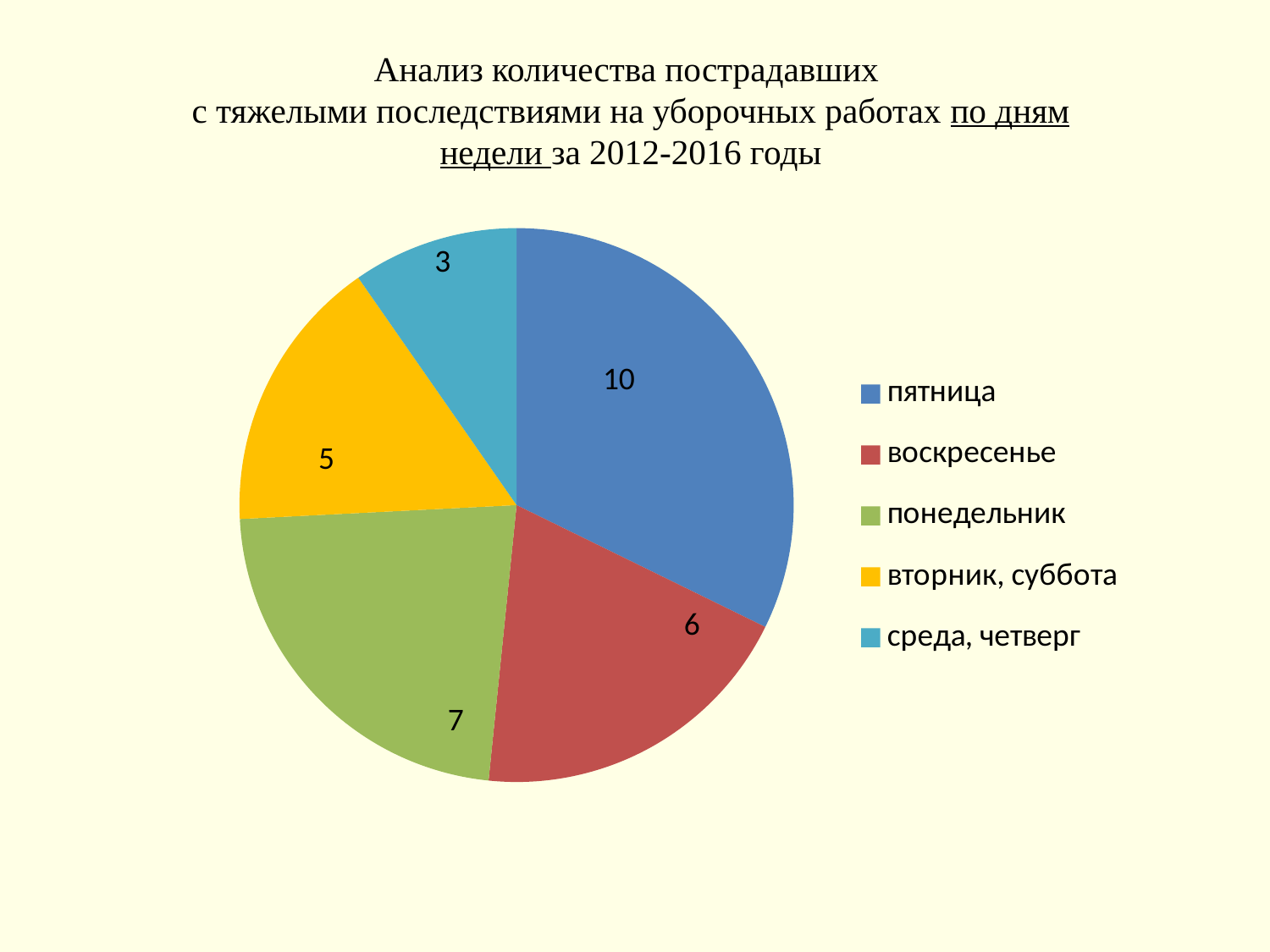
How many slices does the pie chart have? 5 What is the difference between the values for пятница and среда, четверг? 7 Which category has the lowest value? среда, четверг What is the value for воскресенье? 6 What is the total of all slices in the pie chart? 31 What is the value for понедельник? 7 Which day has the highest number of victims? пятница Which is larger, the value for понедельник or the value for воскресенье? понедельник What kind of chart is shown on the slide? pie chart What is the value for вторник, суббота? 5 What is the value for среда, четверг? 3 What is the value for пятница? 10